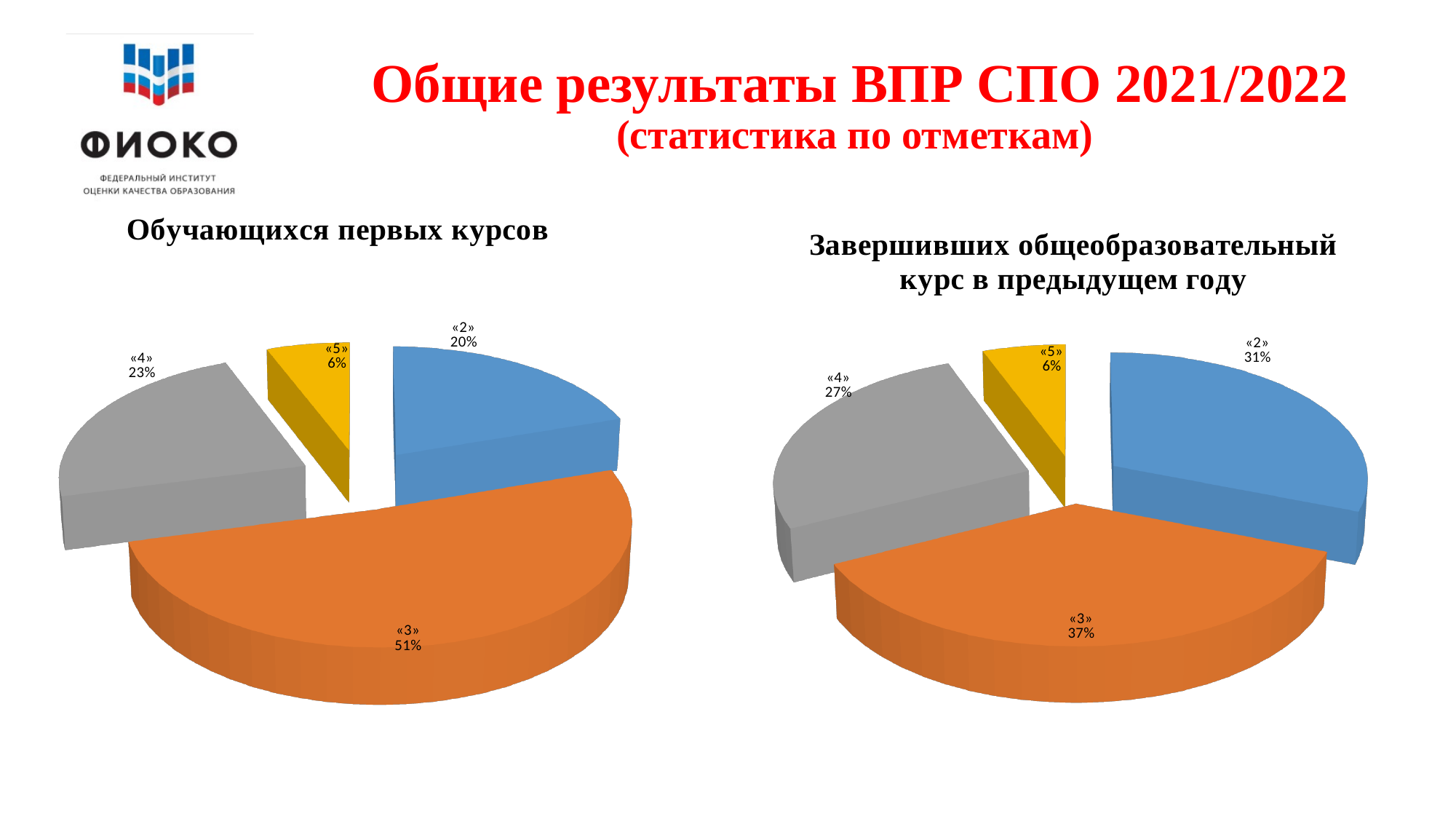
In the left chart (Обучающихся первых курсов), which grade has the largest share? «3» In the left chart (Обучающихся первых курсов), what share of students received a «3»? 51% In the left chart (Обучающихся первых курсов), what colour is the «3» slice? Orange In the left chart (Обучающихся первых курсов), what is the difference in percentage points between the «3» share and the «2» share? 31 In the right chart (Завершивших общеобразовательный курс в предыдущем году), which is larger: the share for «2» or the share for «4»? «2» In the right chart (Завершивших общеобразовательный курс в предыдущем году), which grade has the smallest share? «5» What type of chart is used on the right (Завершивших общеобразовательный курс в предыдущем году)? Pie chart How many slices does the left chart (Обучающихся первых курсов) have? 4 In the right chart (Завершивших общеобразовательный курс в предыдущем году), what share of students received a «2»? 31% What is the difference in percentage points between the «2» share in the right chart and the «2» share in the left chart? 11 In the right chart (Завершивших общеобразовательный курс в предыдущем году), what share of students received a «5»? 6% In the left chart (Обучающихся первых курсов), what share of students received a «4»? 23%